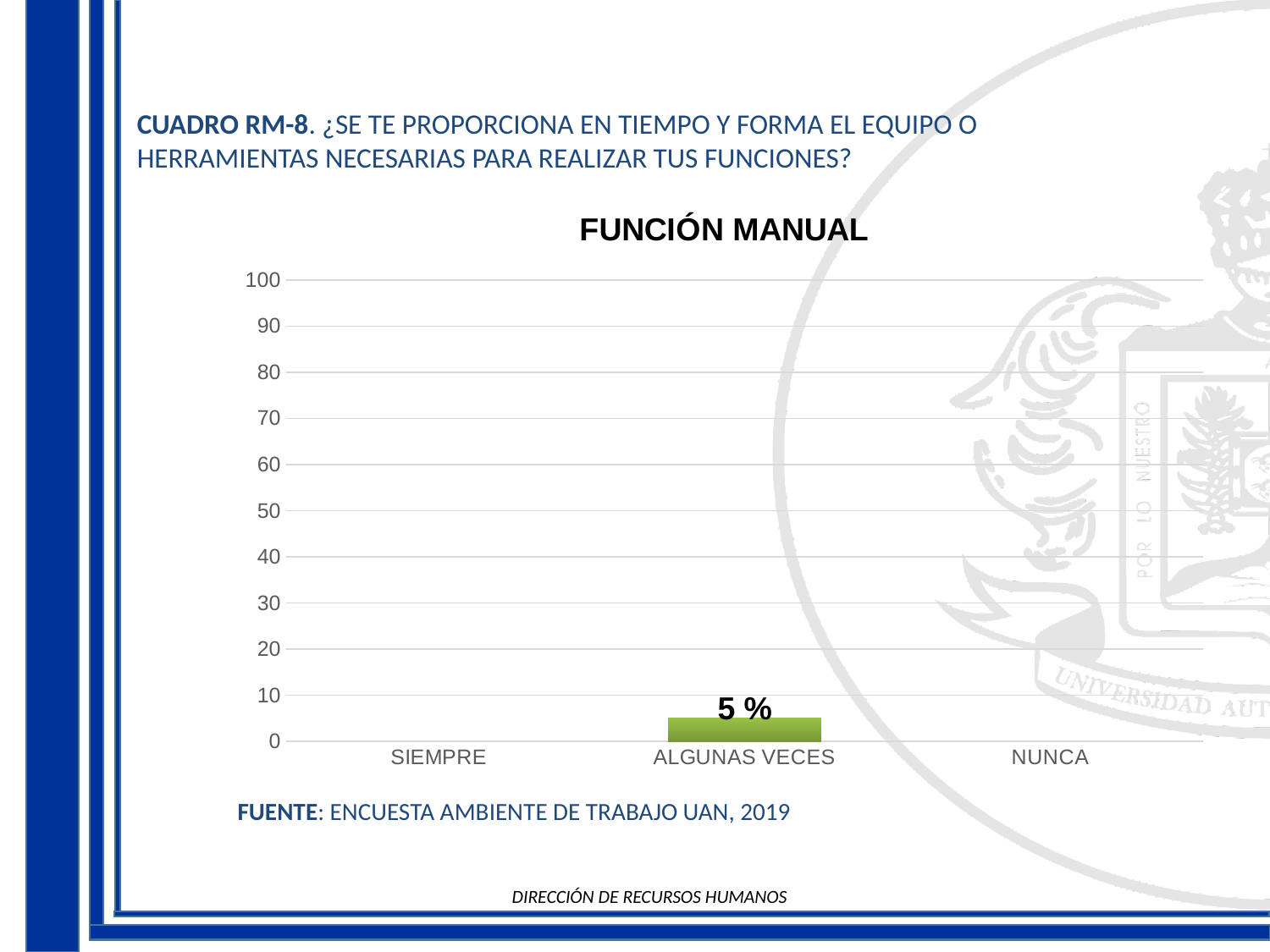
What value is shown for ALGUNAS VECES in the FUNCIÓN MANUAL chart? 5 % What is the title of the chart on the slide? FUNCIÓN MANUAL How many categories are shown on the x axis of the FUNCIÓN MANUAL chart? 3 Which category has the highest value in the FUNCIÓN MANUAL chart? ALGUNAS VECES Is the value for ALGUNAS VECES greater or less than 10? less Is the value for ALGUNAS VECES greater or less than 50? less What kind of chart is the FUNCIÓN MANUAL chart? bar chart Which category is the only one with a visible bar in the FUNCIÓN MANUAL chart? ALGUNAS VECES What is the highest value shown on the y axis of the FUNCIÓN MANUAL chart? 100